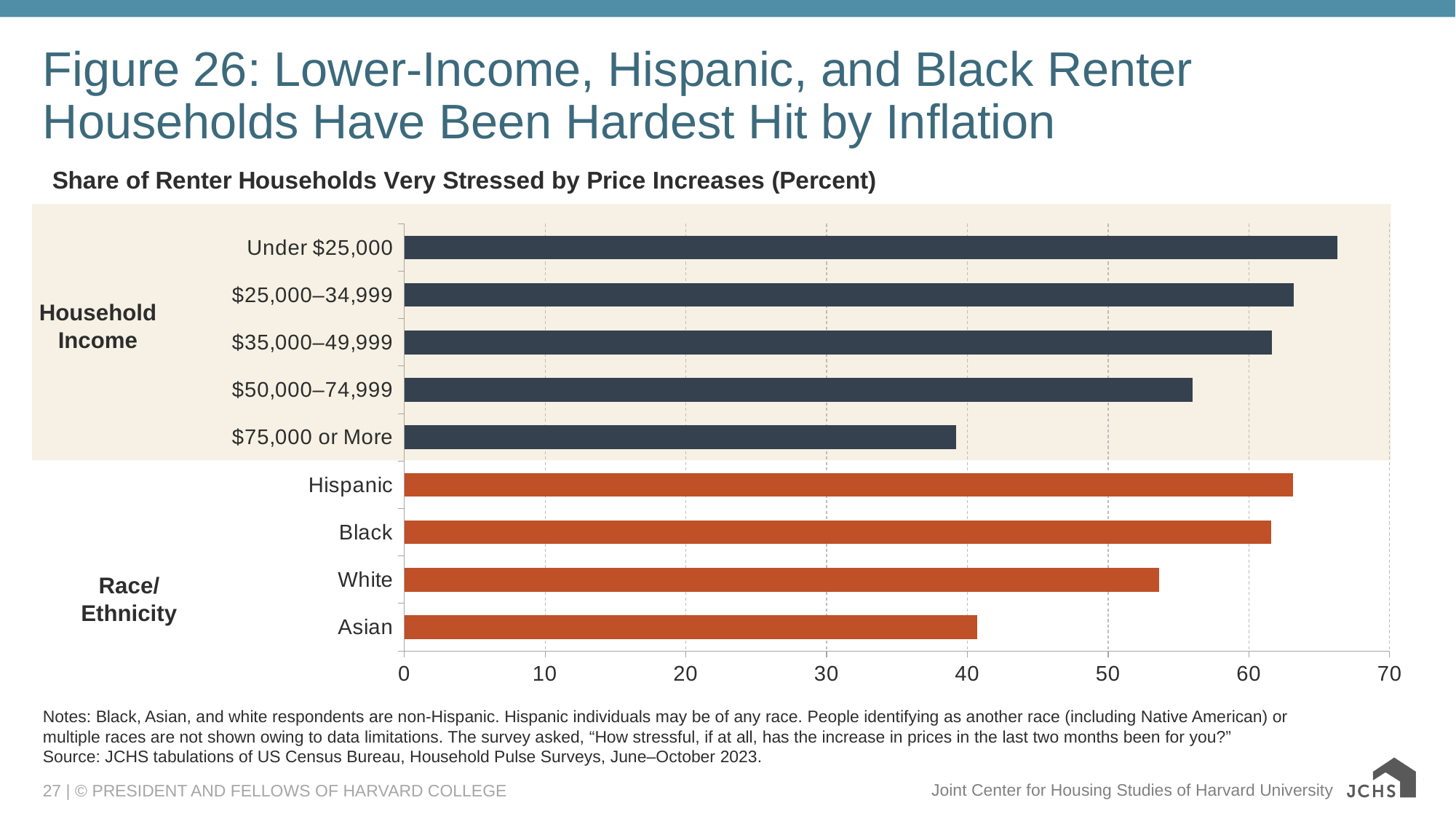
How many categories are plotted in the chart? 9 Among the Household Income categories, which has the lowest share? $75,000 or More What kind of chart is shown on the slide? bar chart Is the value for $75,000 or More greater or less than 50? less What is the subtitle describing the measure plotted in the chart? Share of Renter Households Very Stressed by Price Increases (Percent) Is the value for White greater or less than 50? greater Within the Household Income group, do the values rise or fall as income increases from Under $25,000 to $75,000 or More? fall Which category has the highest share of renter households very stressed by price increases? Under $25,000 Which is larger, the value for Hispanic or the value for White? Hispanic Among the Race/Ethnicity categories, which has the lowest share? Asian Is the value for Hispanic greater or less than 60? greater